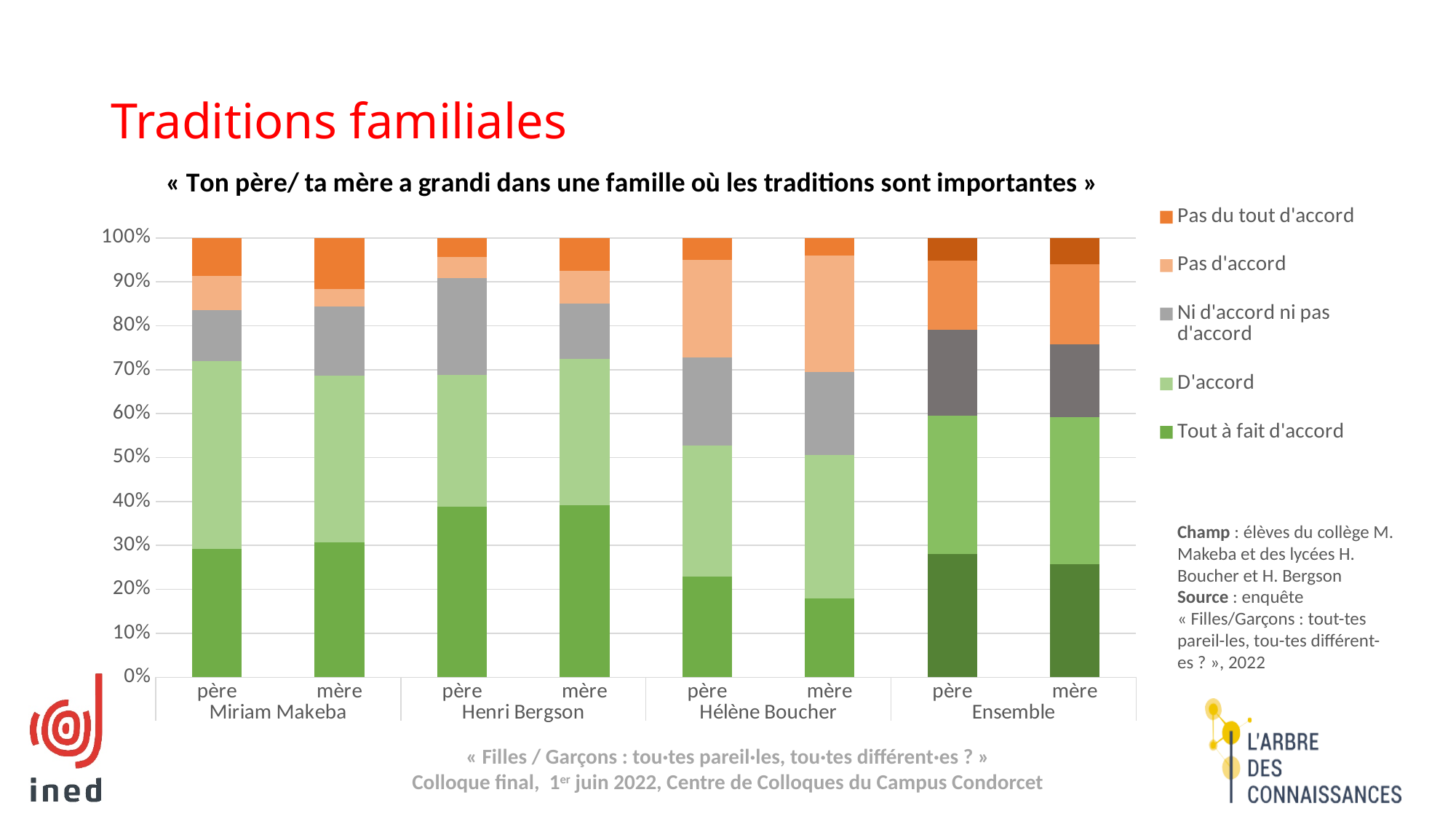
What kind of chart is shown on the slide? Stacked bar chart How many bars are plotted in the chart? 8 Is the 'Tout à fait d'accord' value for Henri Bergson père greater or less than 30%? greater How many groups (schools plus Ensemble) are shown on the x axis? 4 What is the title of the chart? « Ton père/ ta mère a grandi dans une famille où les traditions sont importantes » Is the 'Tout à fait d'accord' value for Ensemble mère greater or less than 30%? less Is the 'Tout à fait d'accord' value for Hélène Boucher mère greater or less than 20%? less For Hélène Boucher, which has the larger 'Tout à fait d'accord' share, père or mère? père Which bar has the smallest 'Tout à fait d'accord' segment? Hélène Boucher mère Which bar has the largest 'Pas du tout d'accord' segment? Miriam Makeba mère How many series does the legend list? 5 Which has the larger 'Tout à fait d'accord' share, Miriam Makeba père or Henri Bergson père? Henri Bergson père